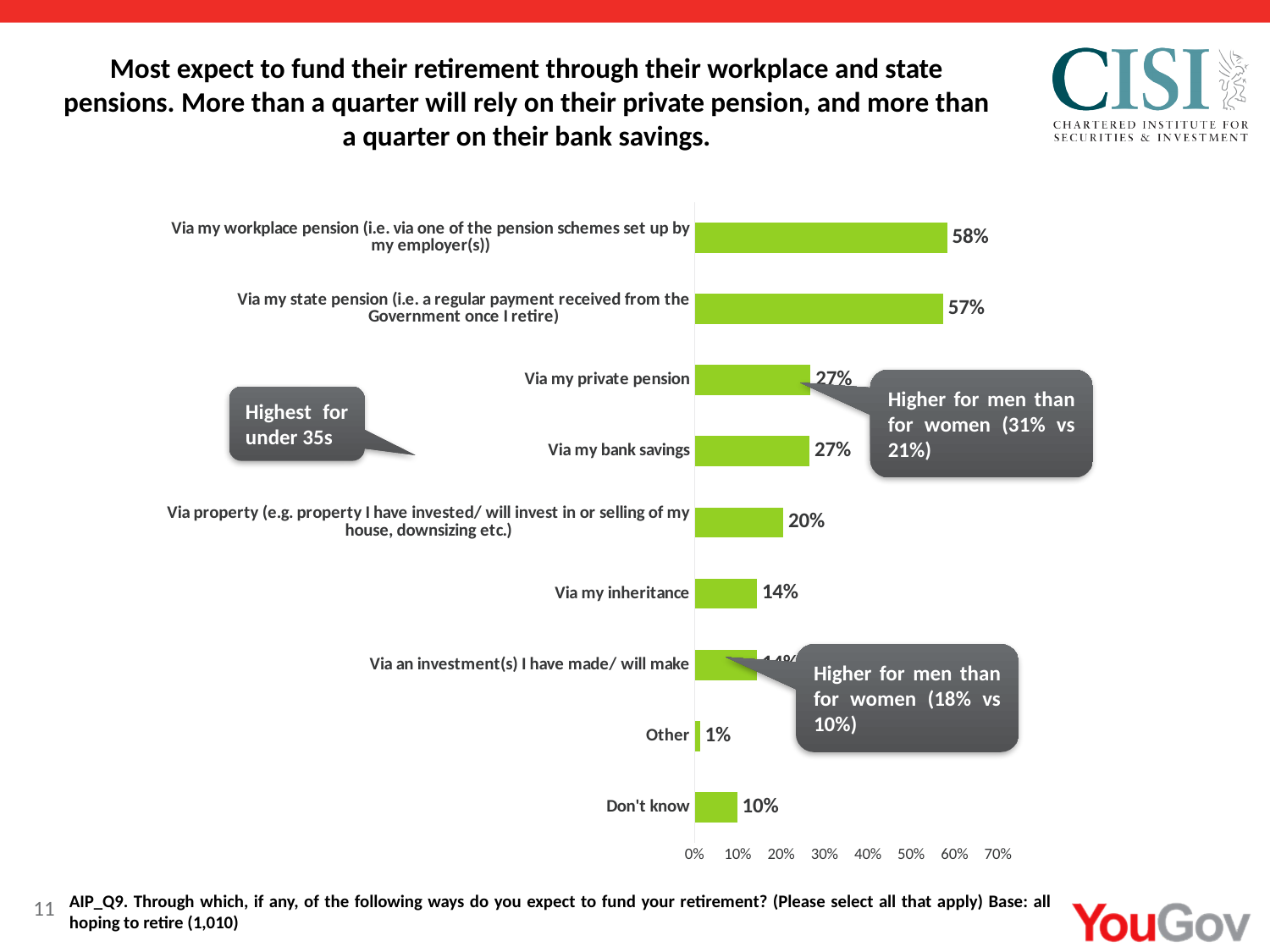
What percentage expect to fund their retirement via their workplace pension? 58% What type of chart is shown on the slide? Bar chart What is the value for 'Don't know'? 10% Which category has the highest value? Via my workplace pension Which is larger: the value for 'Via property' or the value for 'Via my inheritance'? Via property Is the value for 'Via an investment(s) I have made/ will make' greater or less than 20%? less What percentage expect to fund their retirement via their state pension? 57% How many categories are shown in the chart? 9 What is the difference between the workplace pension value and the private pension value? 31 percentage points What is the value for 'Via property'? 20% Which category has the lowest value? Other What is the value for 'Via my bank savings'? 27%